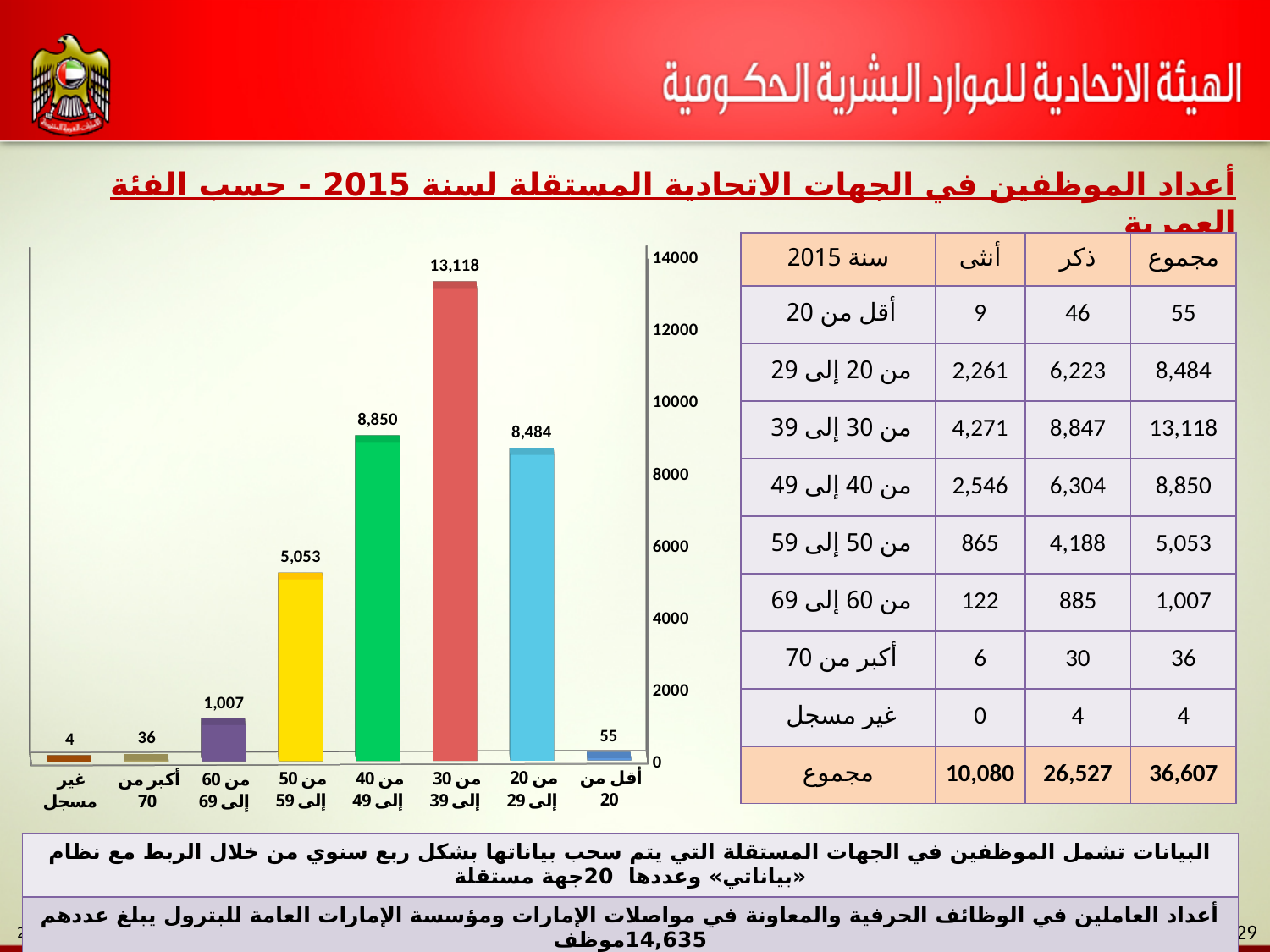
Which category has the lowest bar in the chart? غير مسجل Is the value for "من 50 إلى 59" in the chart greater or less than 6000? less What kind of chart is shown on the slide? bar chart What is the difference between the values for "من 30 إلى 39" and "من 40 إلى 49" in the chart? 4,268 What is the value for the "من 30 إلى 39" bar in the chart? 13,118 What is the value for the "من 50 إلى 59" bar in the chart? 5,053 What is the highest value shown on the chart's vertical axis? 14000 What is the value for the "أقل من 20" bar in the chart? 55 What is the difference between the values for "من 60 إلى 69" and "أكبر من 70" in the chart? 971 How many categories (bars) are shown in the chart? 8 Which is larger in the chart, the value for "من 40 إلى 49" or the value for "من 20 إلى 29"? من 40 إلى 49 Which category has the highest bar in the chart? من 30 إلى 39